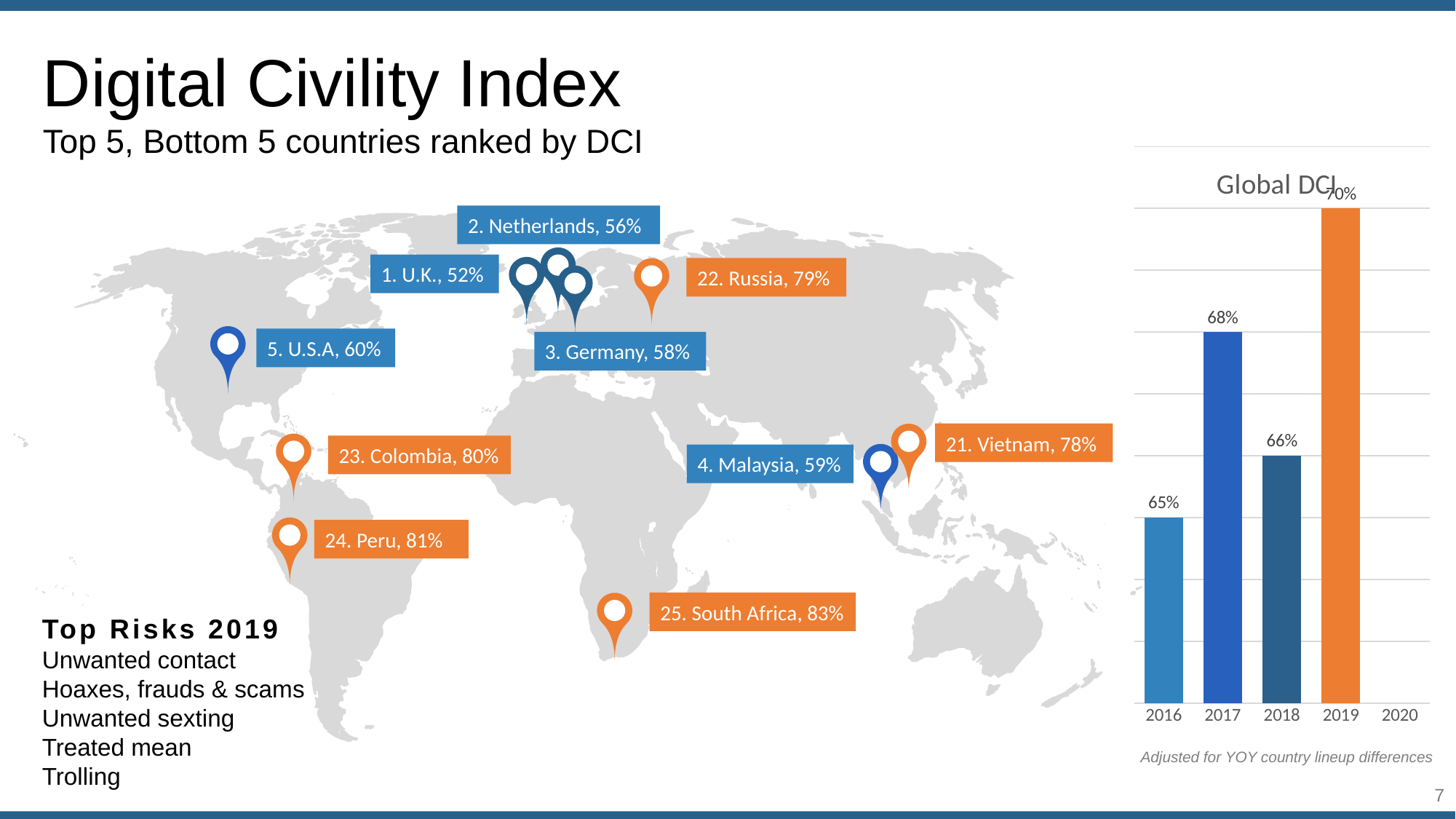
In the Global DCI chart, what is the difference between the 2019 and 2016 values? 5% In the Global DCI chart, what is the value for 2019? 70% In the Global DCI chart, which year has the lowest value? 2016 In the Global DCI chart, which year has the highest value? 2019 In the Global DCI chart, what is the value for 2018? 66% In the Global DCI chart, which is larger, the value for 2017 or the value for 2018? 2017 In the Global DCI chart, what is the value for 2016? 65% In the Global DCI chart, what is the value for 2017? 68% In the Global DCI chart, does the value rise or fall from 2017 to 2018? fall What is the title of the bar chart on the right of the slide? Global DCI In the Global DCI chart, how many bars are plotted? 4 What kind of chart is the Global DCI chart? bar chart